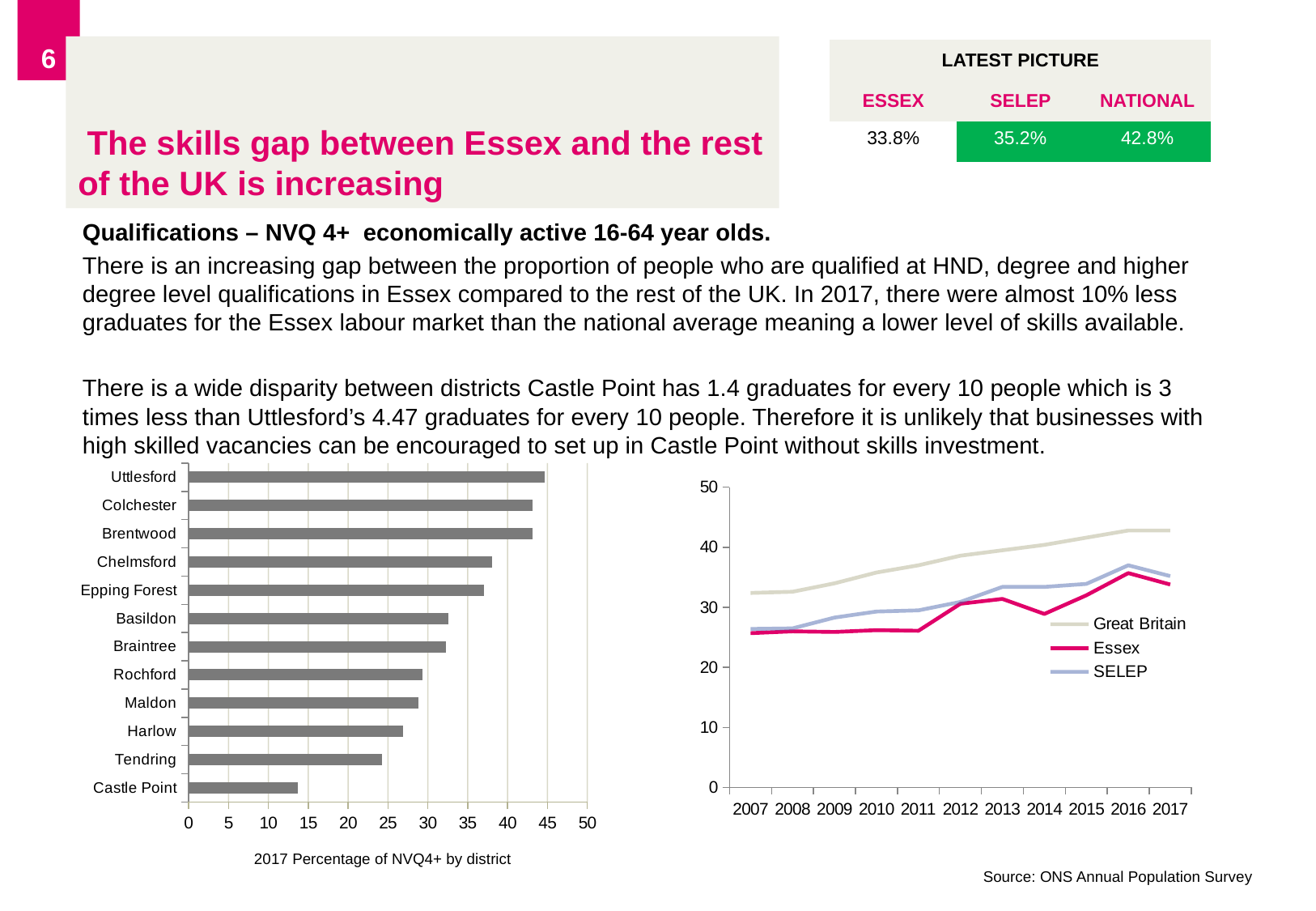
In the chart '2017 Percentage of NVQ4+ by district', is the value for Uttlesford greater or less than 40? greater In the line chart on the right of the slide, how many series does the legend list? 3 In the line chart on the right of the slide, does the Great Britain line generally rise or fall from 2007 to 2017? rise In the chart '2017 Percentage of NVQ4+ by district', which district has the highest value? Uttlesford In the chart '2017 Percentage of NVQ4+ by district', which district has the lowest value? Castle Point In the chart '2017 Percentage of NVQ4+ by district', how many districts are shown? 12 In the line chart on the right of the slide, how many years are shown on the x axis? 11 In the line chart on the right of the slide, which series has the highest value in 2017, Great Britain or Essex? Great Britain In the chart '2017 Percentage of NVQ4+ by district', which has the larger value, Chelmsford or Harlow? Chelmsford In the chart '2017 Percentage of NVQ4+ by district', is the value for Castle Point greater or less than 20? less What kind of chart is the chart titled '2017 Percentage of NVQ4+ by district'? bar chart What kind of chart is the chart on the right of the slide showing Great Britain, Essex and SELEP? line chart